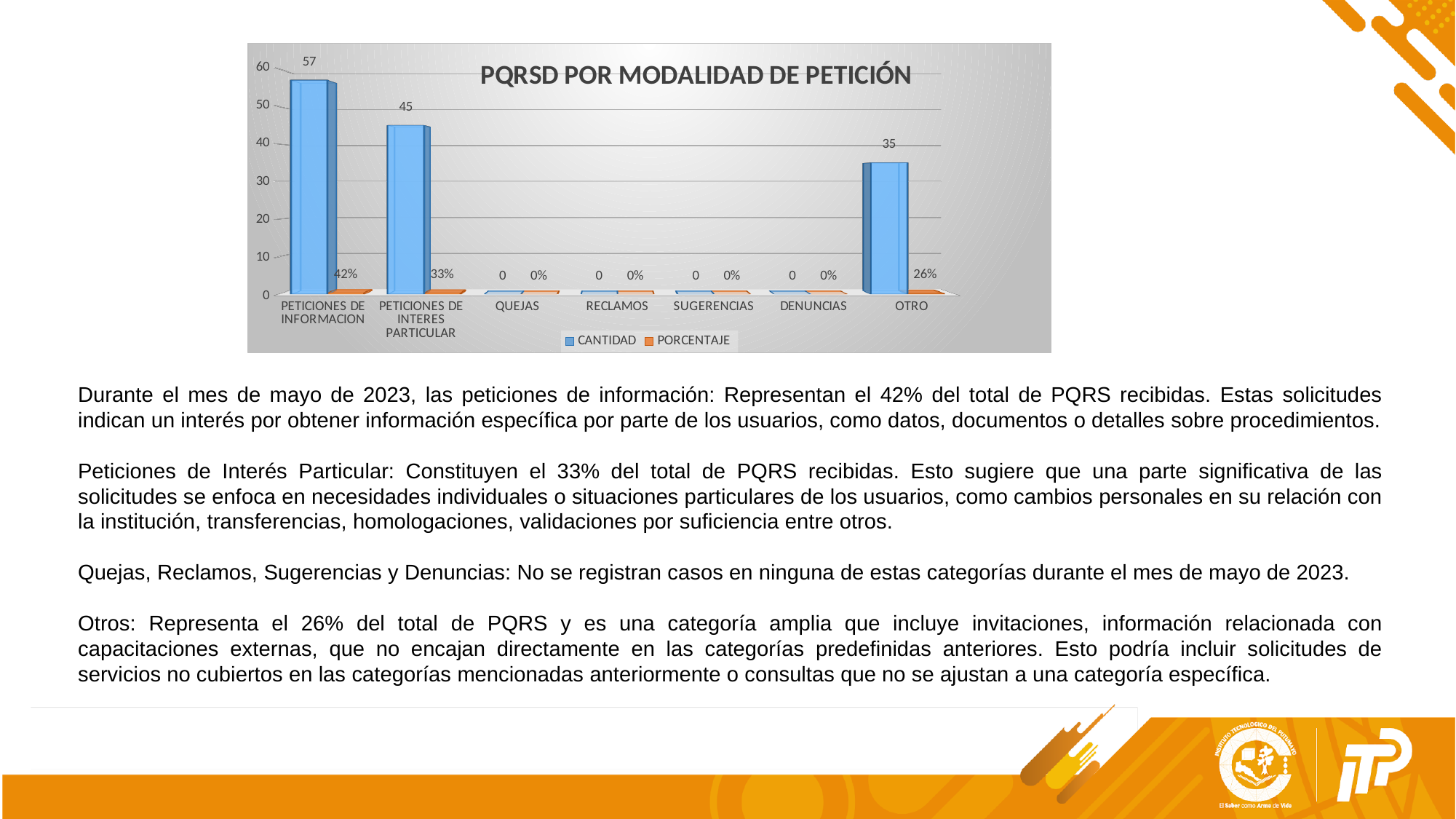
What is the PORCENTAJE value for OTRO? 26% How many series does the legend list? 2 Which has a larger CANTIDAD value, PETICIONES DE INTERES PARTICULAR or OTRO? PETICIONES DE INTERES PARTICULAR How many categories are shown on the x axis? 7 What is the CANTIDAD value for OTRO? 35 What is the PORCENTAJE value for PETICIONES DE INTERES PARTICULAR? 33% What is the CANTIDAD value for PETICIONES DE INFORMACION? 57 What is the difference in CANTIDAD between PETICIONES DE INFORMACION and PETICIONES DE INTERES PARTICULAR? 12 What kind of chart is shown? Bar chart Which category has the highest CANTIDAD value? PETICIONES DE INFORMACION What is the CANTIDAD value for QUEJAS? 0 What is the title of the chart? PQRSD POR MODALIDAD DE PETICIÓN